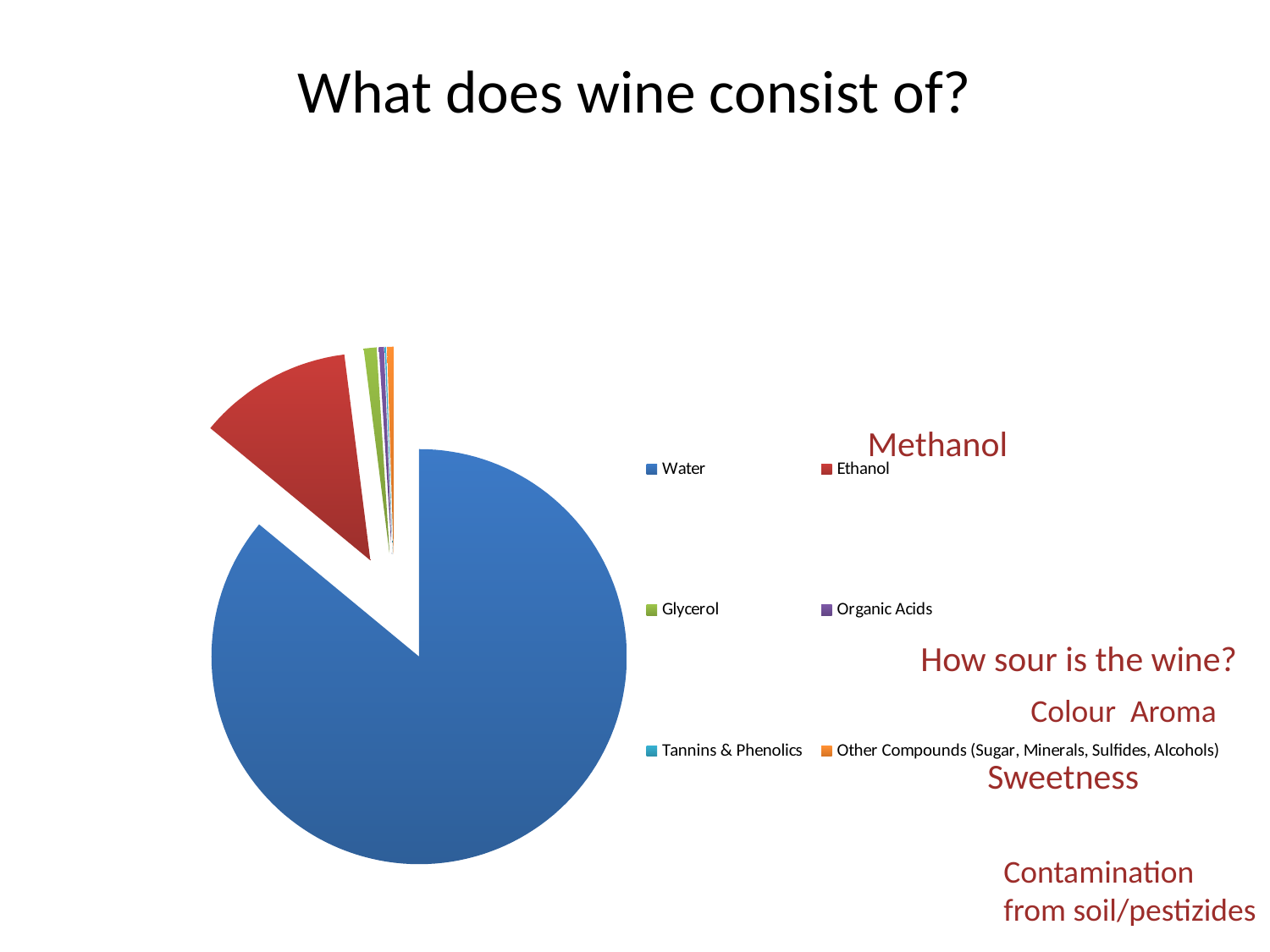
Which slice is larger in the pie chart, Water or Ethanol? Water What colour is the Water slice in the pie chart? blue Which category has the second-largest slice of the pie chart? Ethanol What kind of chart is shown on the slide? pie chart Which legend entry in the pie chart is shown in green? Glycerol Which slice is larger in the pie chart, Ethanol or Glycerol? Ethanol How many categories does the pie chart's legend list? 6 Which slice is larger in the pie chart, Water or Glycerol? Water What is the title of the slide containing the pie chart? What does wine consist of? Which category has the largest slice of the pie chart? Water